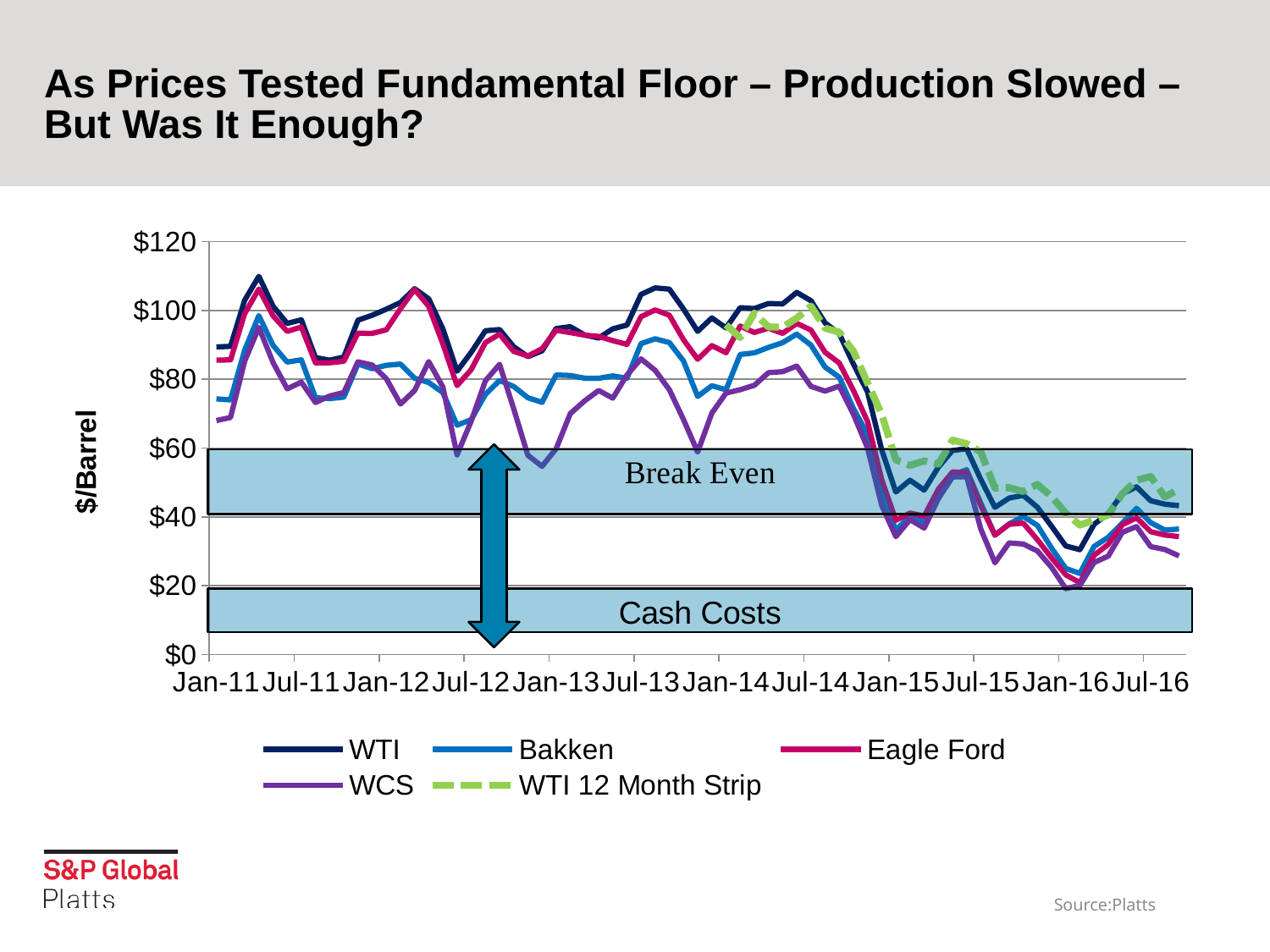
Do the WTI values rise or fall between Jul-14 and Jan-15? fall Is the value for Bakken at Jul-14 greater or less than $80? greater Is the value for WTI at Jan-11 greater or less than $80? greater How many date labels are shown on the x axis? 12 At Jul-12, which is higher, WTI or WCS? WTI What is the label on the vertical axis? $/Barrel Which series has the lowest value at Jan-11? WCS Which series is shown with a dashed line in the legend? WTI 12 Month Strip What kind of chart is shown on the slide? line chart How many series does the legend list? 5 Is the value for WCS at Jan-16 greater or less than $40? less